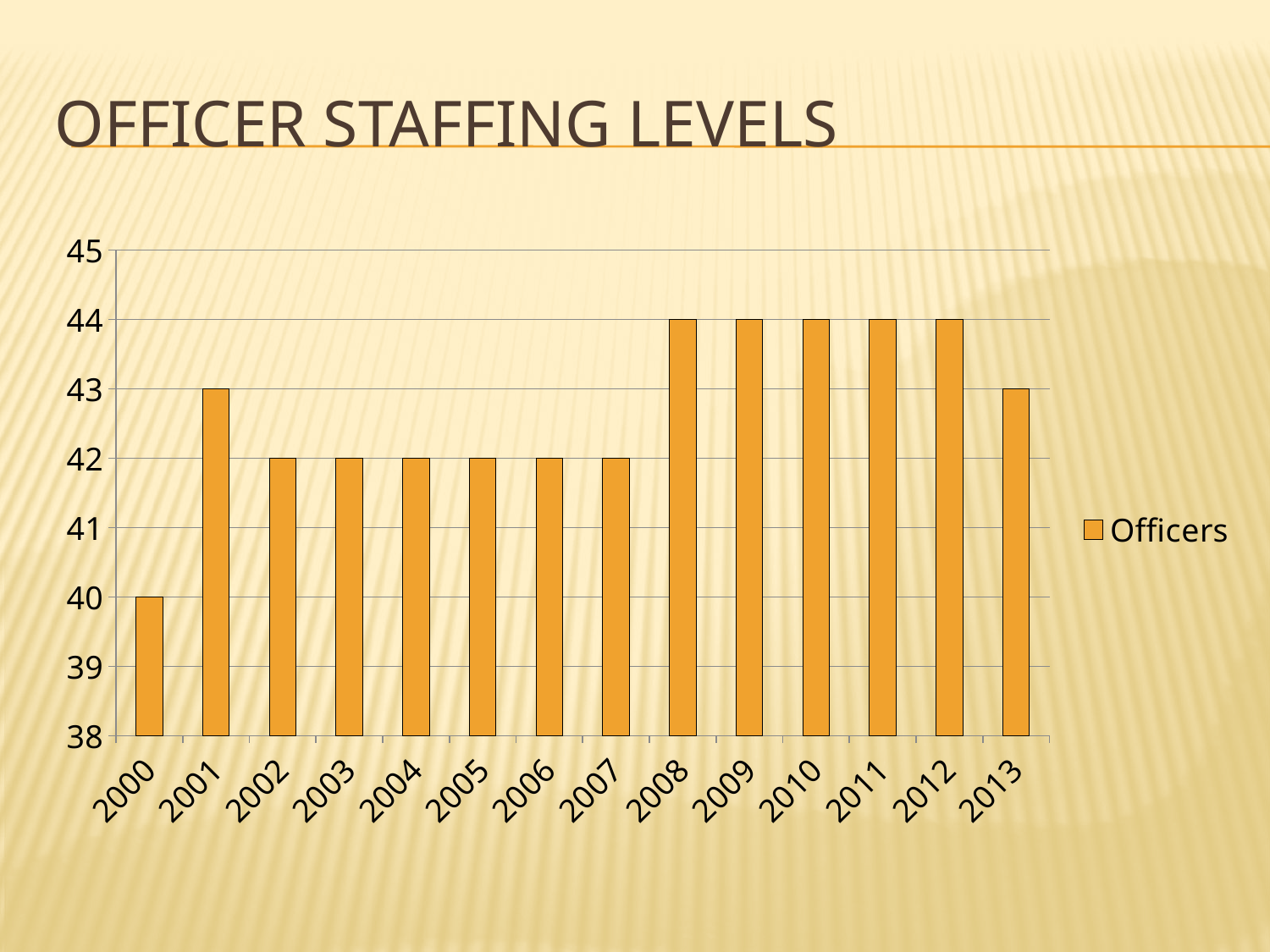
What is the value for 2013? 43 What is the difference between the values for 2008 and 2000? 4 How many years are shown on the x axis? 14 How many series does the legend list? 1 What is the value for 2000? 40 What type of chart is shown on the slide? Bar chart What is the value for 2001? 43 What is the title of the chart? OFFICER STAFFING LEVELS Which is larger, the value for 2001 or the value for 2002? 2001 Which year has the lowest value? 2000 What is the value for 2010? 44 What is the value for 2005? 42